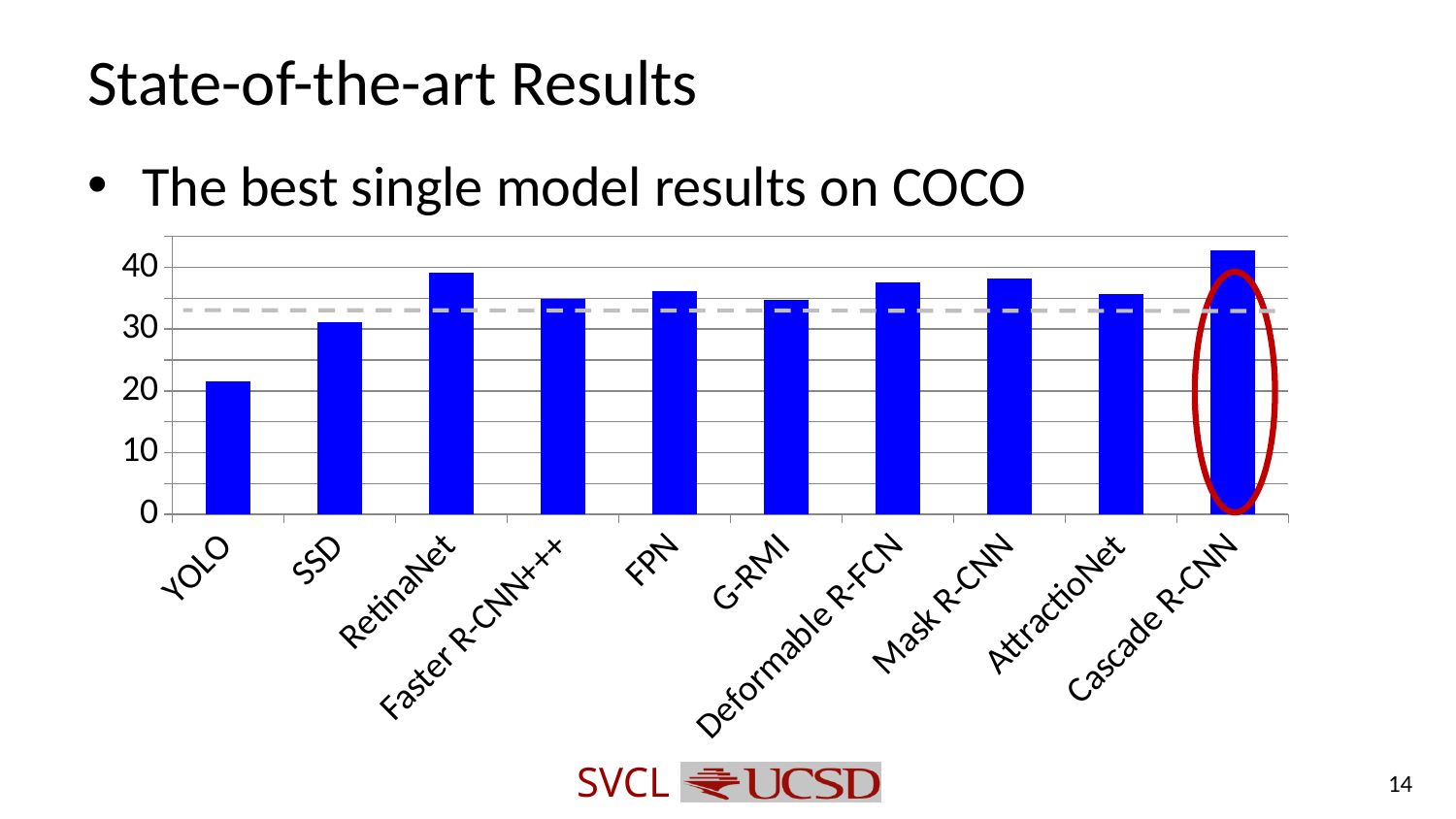
Which model has the highest bar? Cascade R-CNN Is the value for YOLO greater or less than 30? less Is the value for Cascade R-CNN greater or less than 40? greater Which is larger, the value for Cascade R-CNN or the value for RetinaNet? Cascade R-CNN How many models (categories) are plotted on the x axis? 10 Is the value for SSD greater or less than 40? less Which is larger, the value for YOLO or the value for SSD? SSD Which model has the lowest bar? YOLO What kind of chart is shown on the slide? bar chart Which bar on the chart is circled in red? Cascade R-CNN